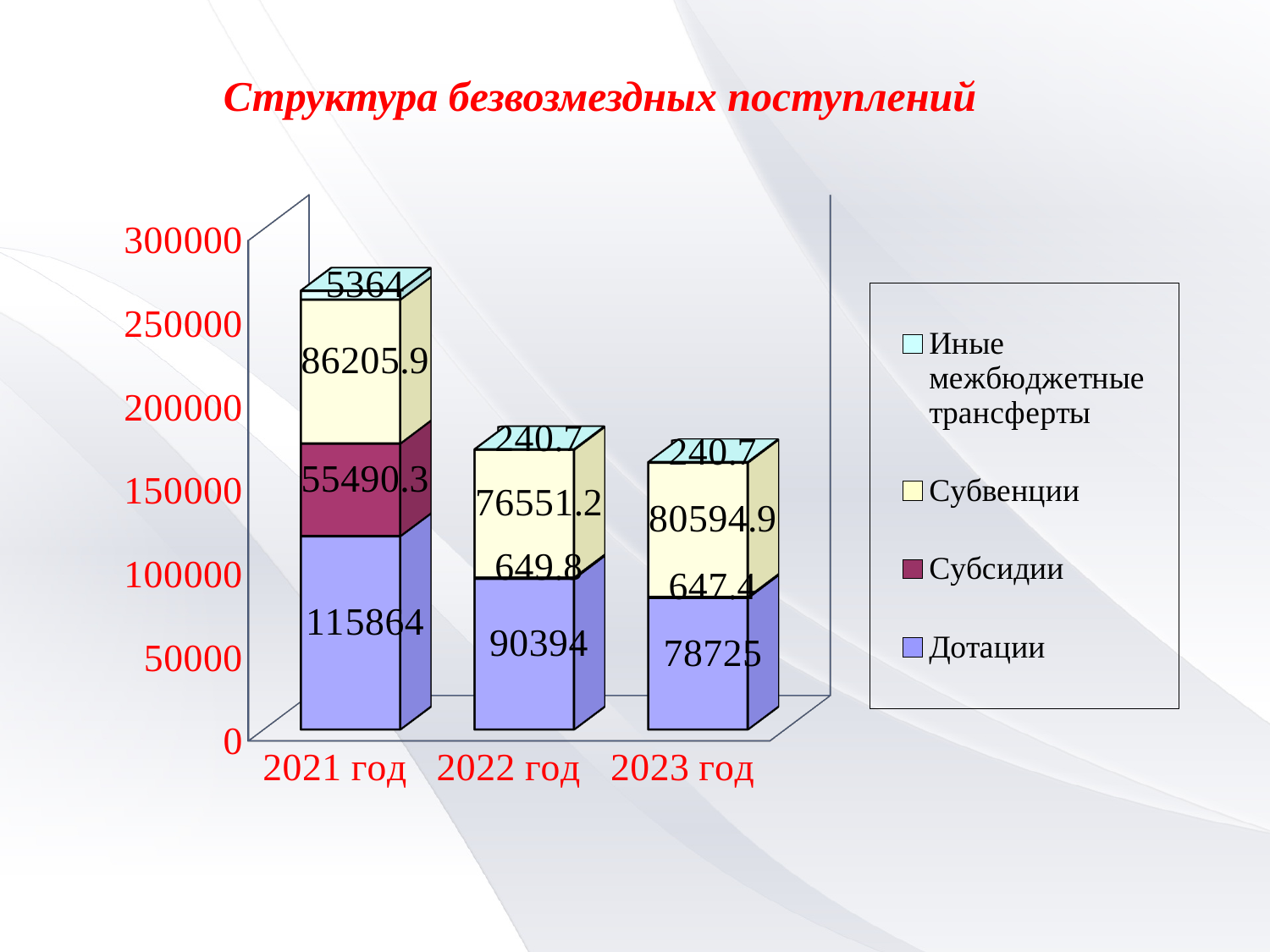
In which year is the value of Дотации the highest? 2021 год What kind of chart is shown on the slide? Stacked bar chart What is the value of Субсидии for 2022 год? 649.8 What is the value of Субвенции for 2023 год? 80594.9 Which is larger: Субвенции in 2022 год or Субвенции in 2023 год? Субвенции in 2023 год What is the difference between Дотации in 2022 год and 2023 год? 11669 How many series does the legend list? 4 What is the value of Иные межбюджетные трансферты for 2021 год? 5364 What is the value of Дотации for 2021 год? 115864 How many years are shown on the x axis? 3 In which year is the value of Субсидии the lowest? 2023 год What is the total of the stacked bar for 2022 год? 167835.7